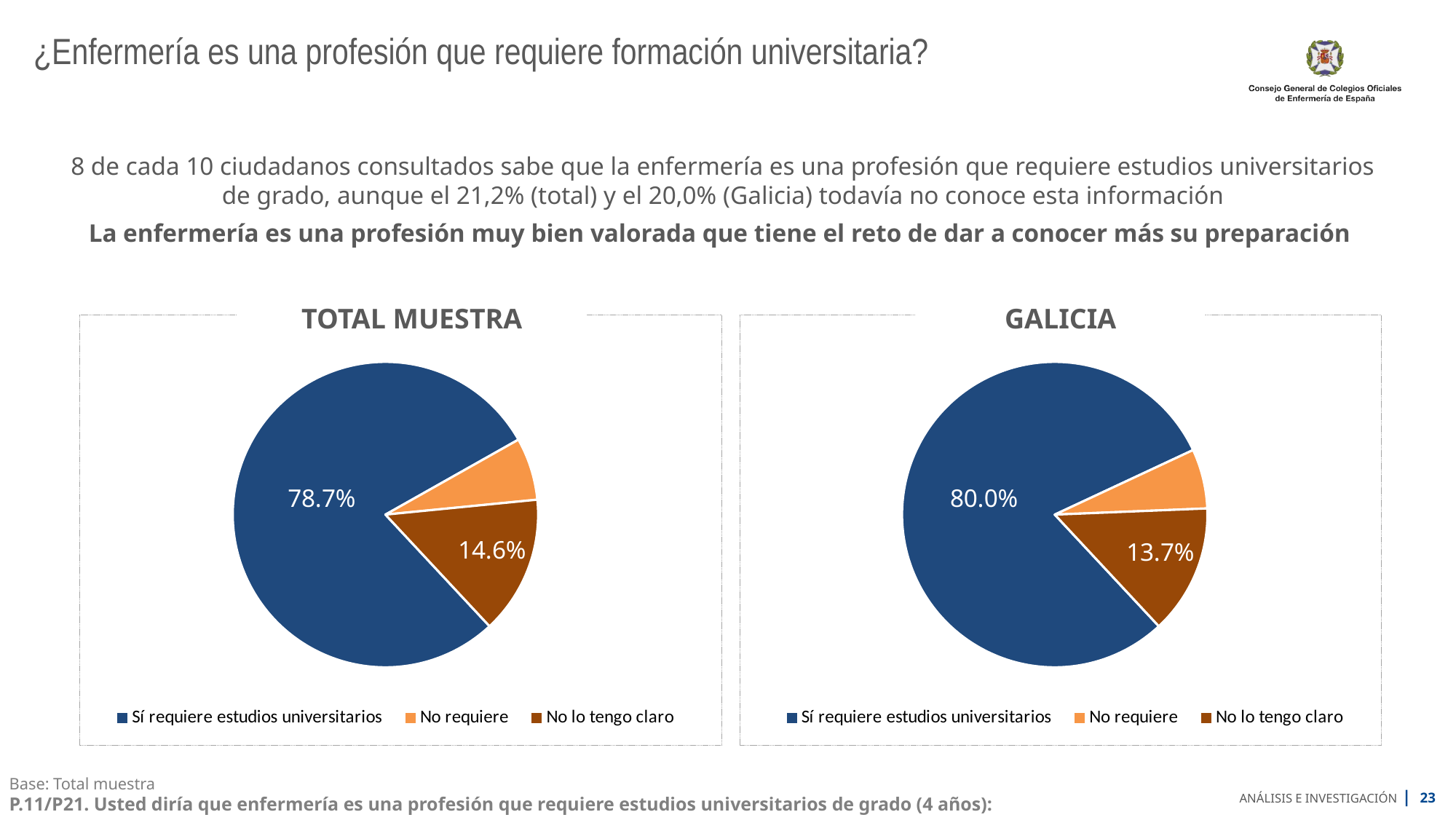
In the TOTAL MUESTRA chart, which response has the smallest slice? No requiere In the GALICIA chart, which response has the largest slice? Sí requiere estudios universitarios In the TOTAL MUESTRA chart, what percentage answered 'No lo tengo claro'? 14.6% What is the difference in percentage points between 'Sí requiere estudios universitarios' in the GALICIA chart and in the TOTAL MUESTRA chart? 1.3 percentage points In the TOTAL MUESTRA chart, what is the difference in percentage points between 'Sí requiere estudios universitarios' and 'No lo tengo claro'? 64.1 percentage points In the TOTAL MUESTRA chart, what colour represents 'No lo tengo claro'? Brown What type of chart is used for TOTAL MUESTRA? Pie chart In the GALICIA chart, what percentage answered 'Sí requiere estudios universitarios'? 80.0% How many slices does the GALICIA pie chart have? 3 In the TOTAL MUESTRA chart, what percentage answered 'Sí requiere estudios universitarios'? 78.7% Is the share of 'Sí requiere estudios universitarios' larger in the TOTAL MUESTRA chart or the GALICIA chart? GALICIA In the GALICIA chart, what percentage answered 'No lo tengo claro'? 13.7%